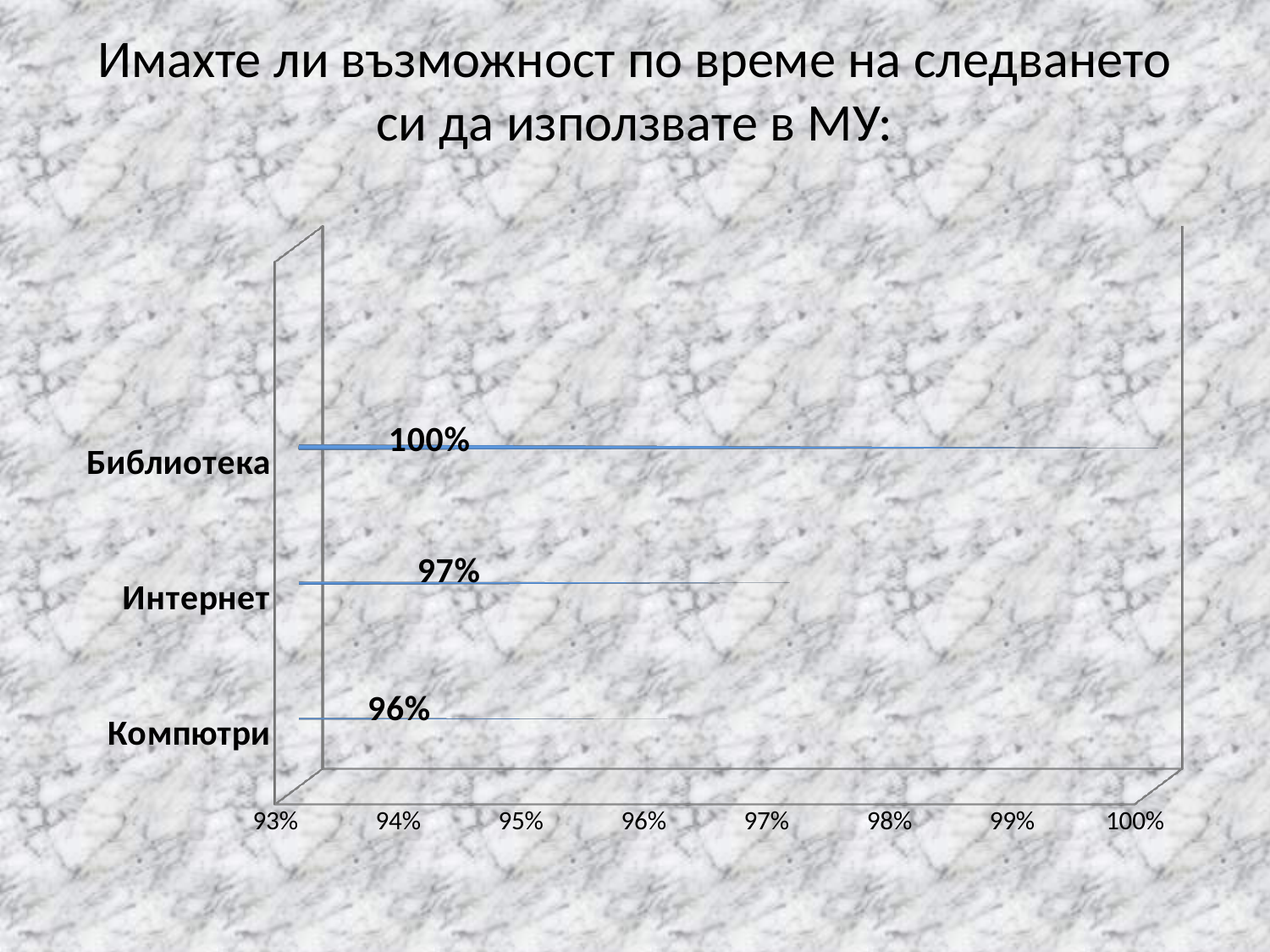
Is the value for Интернет greater or less than 95%? greater What is the value for Библиотека? 100% What is the value for Компютри? 96% What is the title of the slide? Имахте ли възможност по време на следването си да използвате в МУ: Which is larger, the value for Интернет or the value for Компютри? Интернет What is the value for Интернет? 97% Which category has the highest value? Библиотека How many categories are shown in the chart? 3 Which category has the lowest value? Компютри What kind of chart is shown on the slide? bar chart What is the difference between the values for Интернет and Компютри? 1% What is the difference between the values for Библиотека and Компютри? 4%